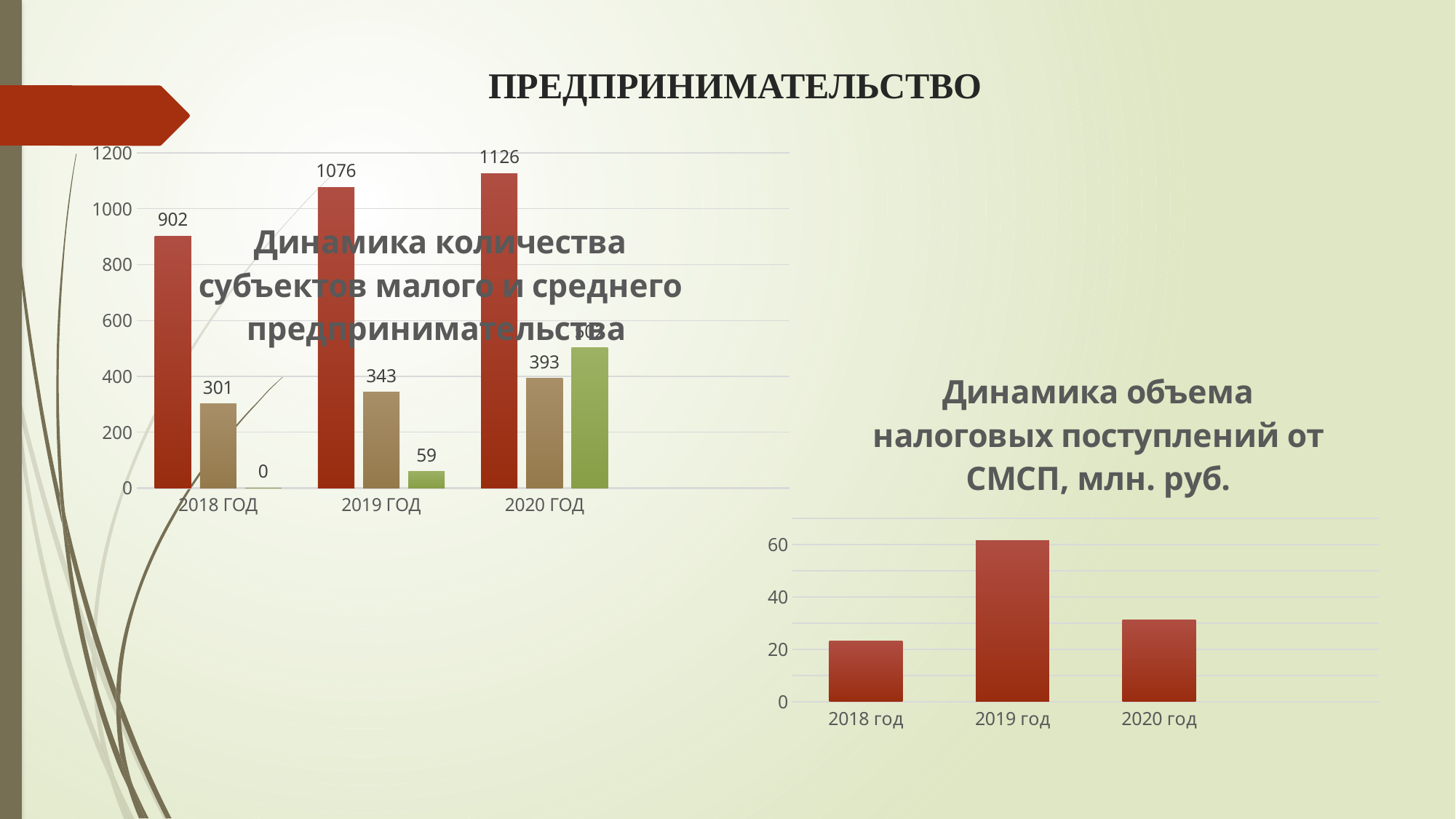
In the chart 'Динамика количества субъектов малого и среднего предпринимательства', what is the value of the red bar for 2018 год? 902 In the chart 'Динамика количества субъектов малого и среднего предпринимательства', what is the value of the red bar for 2020 год? 1126 In the chart 'Динамика количества субъектов малого и среднего предпринимательства', what is the value of the green bar for 2018 год? 0 In the chart 'Динамика количества субъектов малого и среднего предпринимательства', what is the difference between the brown bar values for 2020 год and 2019 год? 50 What kind of chart is 'Динамика объема налоговых поступлений от СМСП, млн. руб.'? bar chart In the chart 'Динамика объема налоговых поступлений от СМСП, млн. руб.', which year has the highest value? 2019 год How many years are shown on the x axis of the chart 'Динамика объема налоговых поступлений от СМСП, млн. руб.'? 3 In the chart 'Динамика объема налоговых поступлений от СМСП, млн. руб.', is the value for 2019 год greater or less than 40? greater In the chart 'Динамика количества субъектов малого и среднего предпринимательства', what is the difference between the red bar values for 2019 год and 2018 год? 174 In the chart 'Динамика количества субъектов малого и среднего предпринимательства', what is the value of the brown bar for 2019 год? 343 In the chart 'Динамика количества субъектов малого и среднего предпринимательства', do the red bar values rise or fall from 2018 to 2020? rise In the chart 'Динамика количества субъектов малого и среднего предпринимательства', which year has the highest red bar? 2020 год